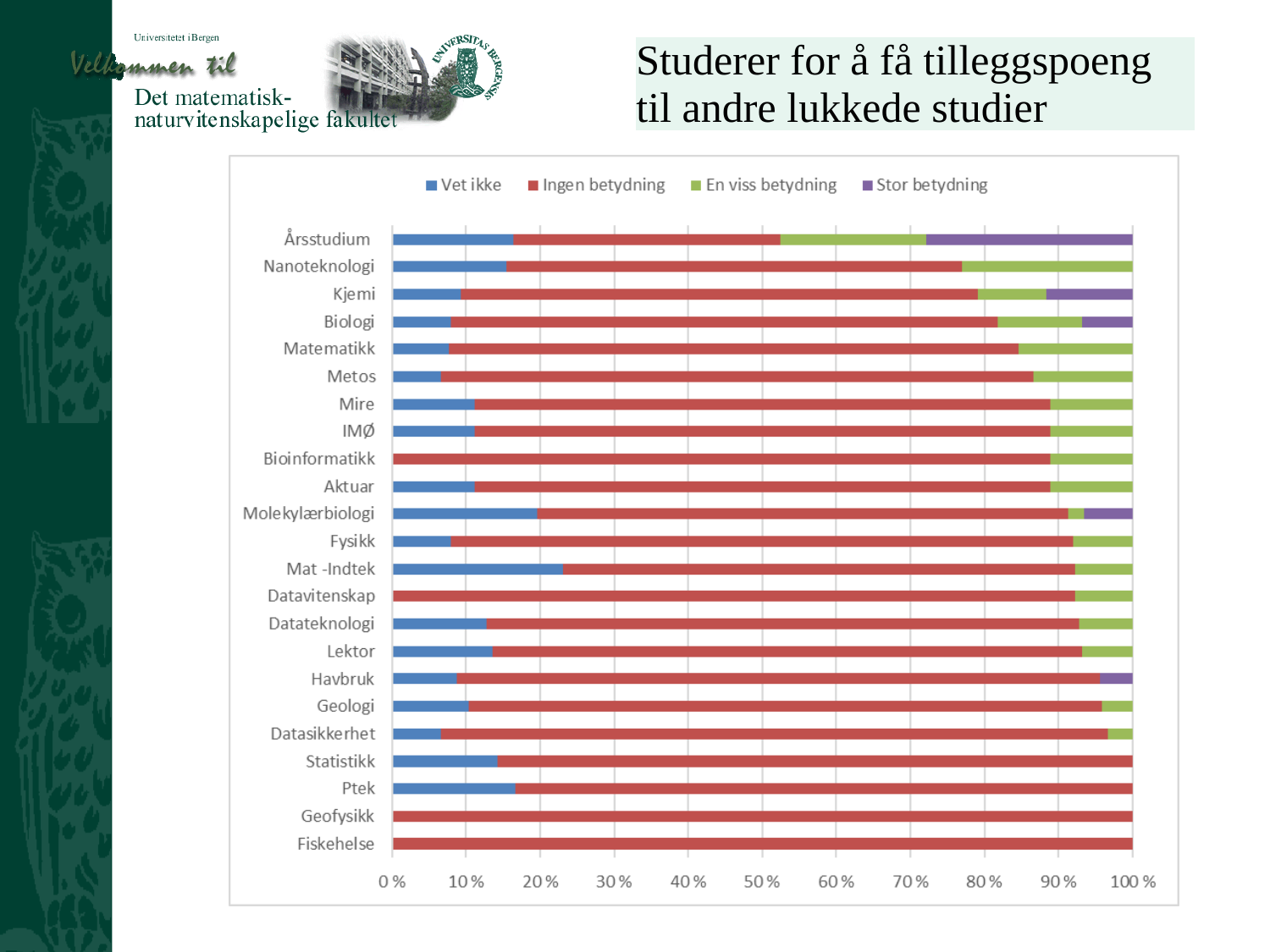
What is the title of the slide containing the chart? Studerer for å få tilleggspoeng til andre lukkede studier Which category has the largest 'Stor betydning' share? Årsstudium Which has the larger 'Vet ikke' share, Ptek or Kjemi? Ptek What kind of chart is shown on the slide? Stacked bar chart What is the 'Ingen betydning' value for Fiskehelse? 100 % Which series are listed in the legend? Vet ikke, Ingen betydning, En viss betydning, Stor betydning Which category has the largest 'Vet ikke' share? Mat -Indtek How many study programmes (categories) are shown on the chart? 23 Is the 'Vet ikke' value for Metos greater or less than 10 %? less How many series does the legend list? 4 Is the 'Vet ikke' value for Mat -Indtek greater or less than 20 %? greater Which has the larger 'Ingen betydning' share, Geofysikk or Årsstudium? Geofysikk